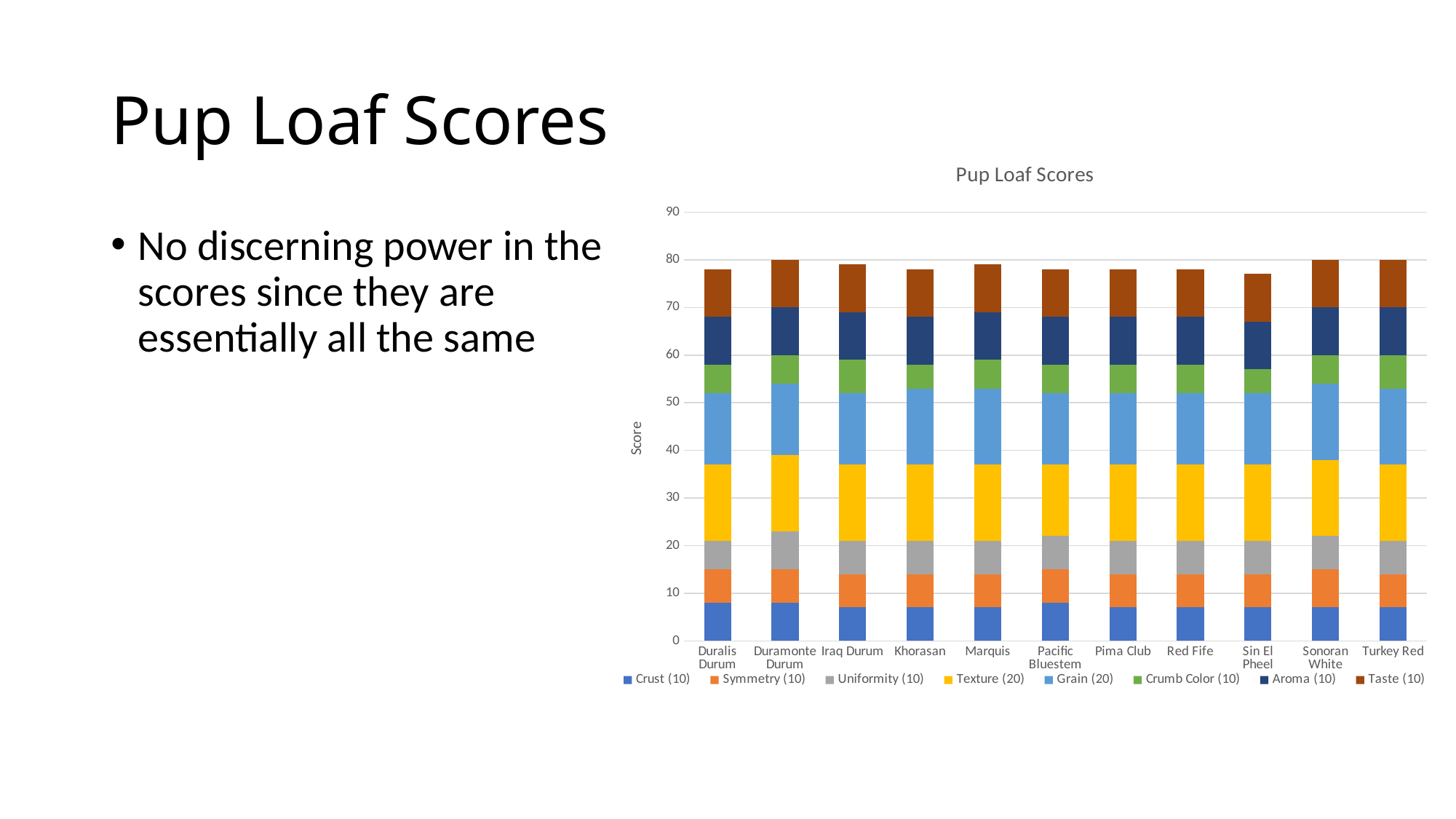
What is the title of the chart? Pup Loaf Scores Is the total stacked score for Pima Club greater or less than 80? less What is the label on the vertical axis of the chart? Score Is the total stacked score for Duralis Durum greater or less than 70? greater What kind of chart is shown on the slide? Stacked bar chart Is the total stacked score for Sin El Pheel greater or less than 80? less How many series does the chart's legend list? 8 How many wheat varieties (categories) are shown on the x axis of the chart? 11